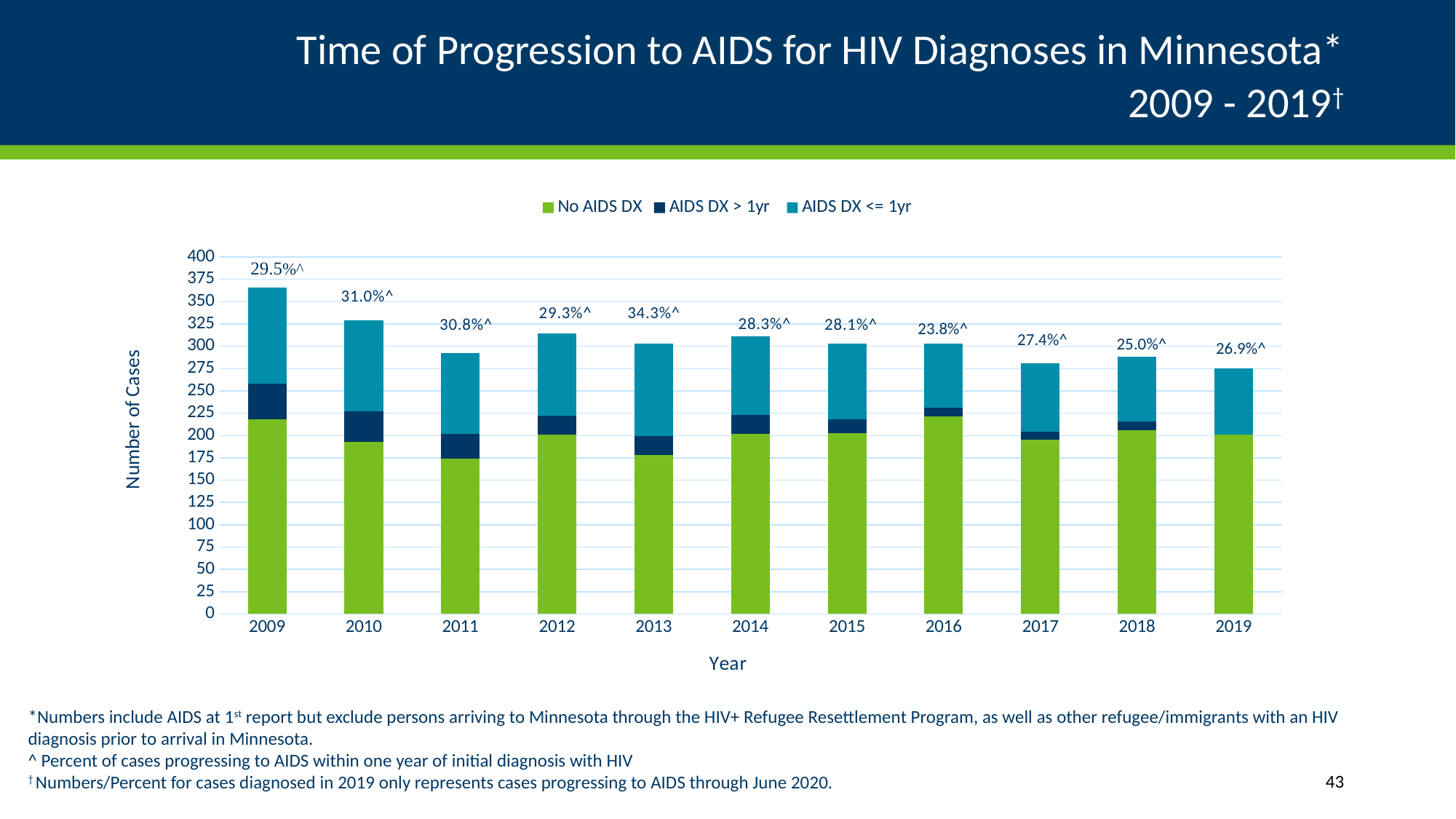
Which year has the larger percentage label, 2010 or 2011? 2010 Is the total number of cases for 2019 greater or less than 300? less What percentage label is shown above the 2019 bar? 26.9% What percentage label is shown above the 2013 bar? 34.3% What is the difference in percentage points between the 2013 label (34.3%) and the 2016 label (23.8%)? 10.5 percentage points Which year has the lowest percentage of cases progressing to AIDS within one year? 2016 Is the No AIDS DX value for 2011 greater or less than 200? less How many years are shown on the x axis? 11 Is the total number of cases for 2009 greater or less than 350? greater How many series does the legend list? 3 Which year has the highest percentage of cases progressing to AIDS within one year? 2013 What kind of chart is shown on the slide? Stacked bar chart